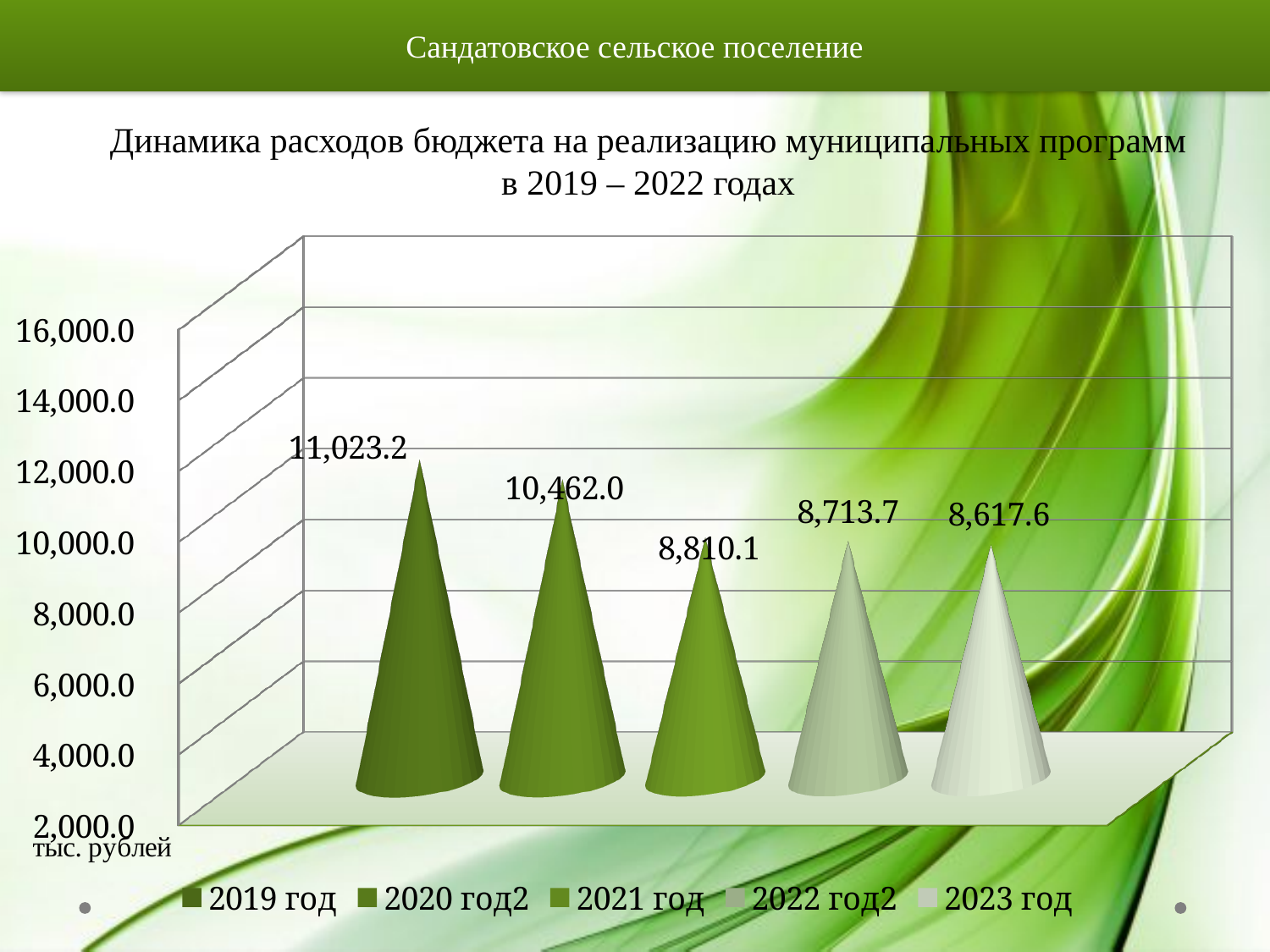
Is the value for 2022 год2 greater or less than 10,000.0? less What is the value for 2023 год? 8,617.6 What is the value for 2019 год? 11,023.2 What kind of chart is shown on the slide? bar chart What is the value for 2021 год? 8,810.1 Which year has the highest value? 2019 год How many series does the legend list? 5 Which year has the lowest value? 2023 год What is the difference between the values for 2019 год and 2020 год2? 561.2 Do the values rise or fall from 2019 год to 2023 год? fall What is the difference between the values for 2019 год and 2023 год? 2,405.6 Which is larger, the value for 2020 год2 or the value for 2021 год? 2020 год2